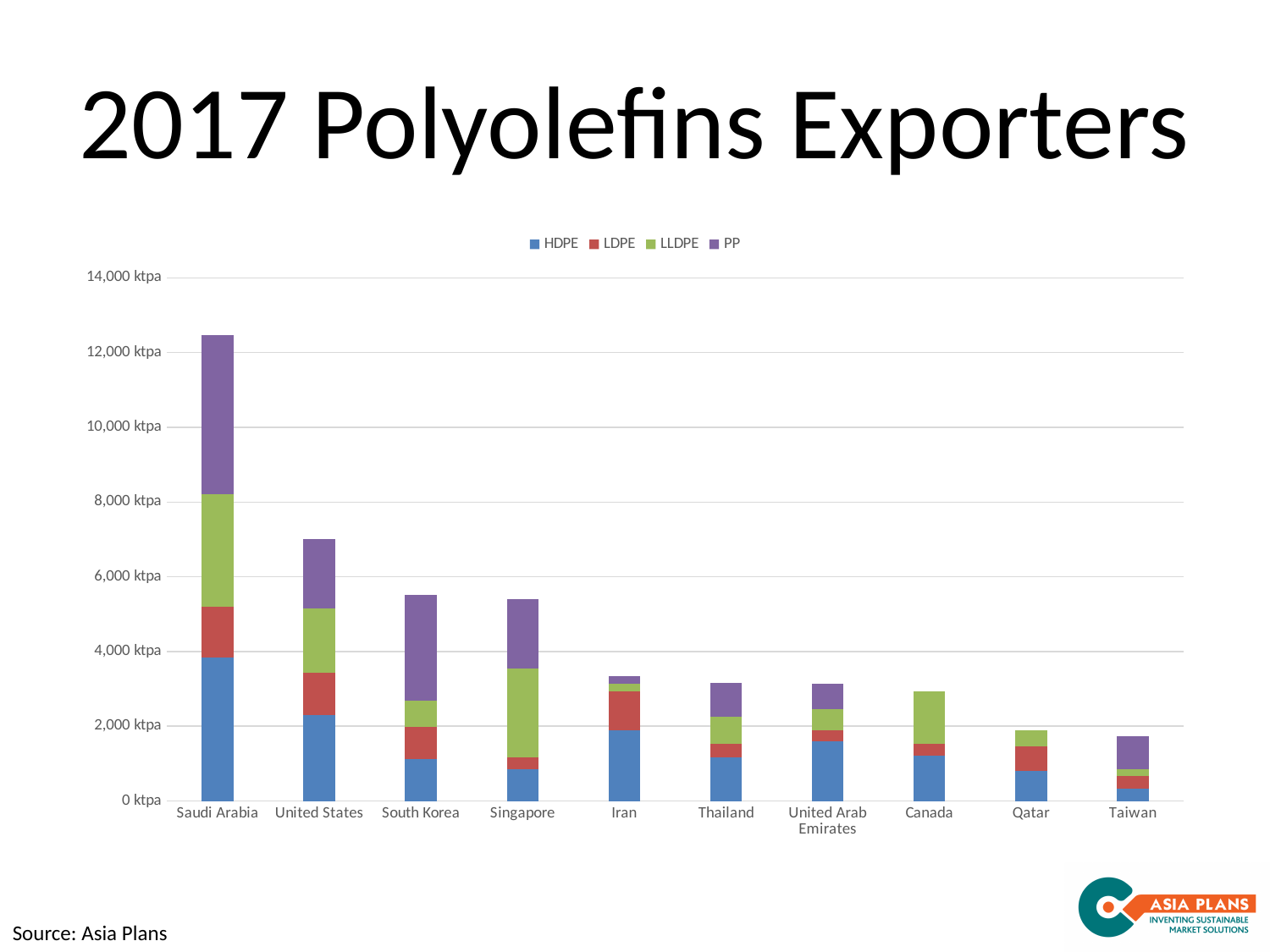
Which has the larger total bar, Canada or Qatar? Canada Is the total bar for United States greater or less than 6,000 ktpa? greater Do the total bar heights generally rise or fall moving from left to right along the x axis? Fall What are the four series listed in the chart's legend? HDPE, LDPE, LLDPE, PP Which country has the highest total polyolefins exports in the chart? Saudi Arabia Is the total bar for Taiwan greater or less than 2,000 ktpa? less What kind of chart is shown on the slide? Stacked bar chart Is the total bar for Iran greater or less than 4,000 ktpa? less How many series does the chart's legend list? 4 Which has the larger total bar, United States or South Korea? United States How many countries are shown on the x axis of the chart? 10